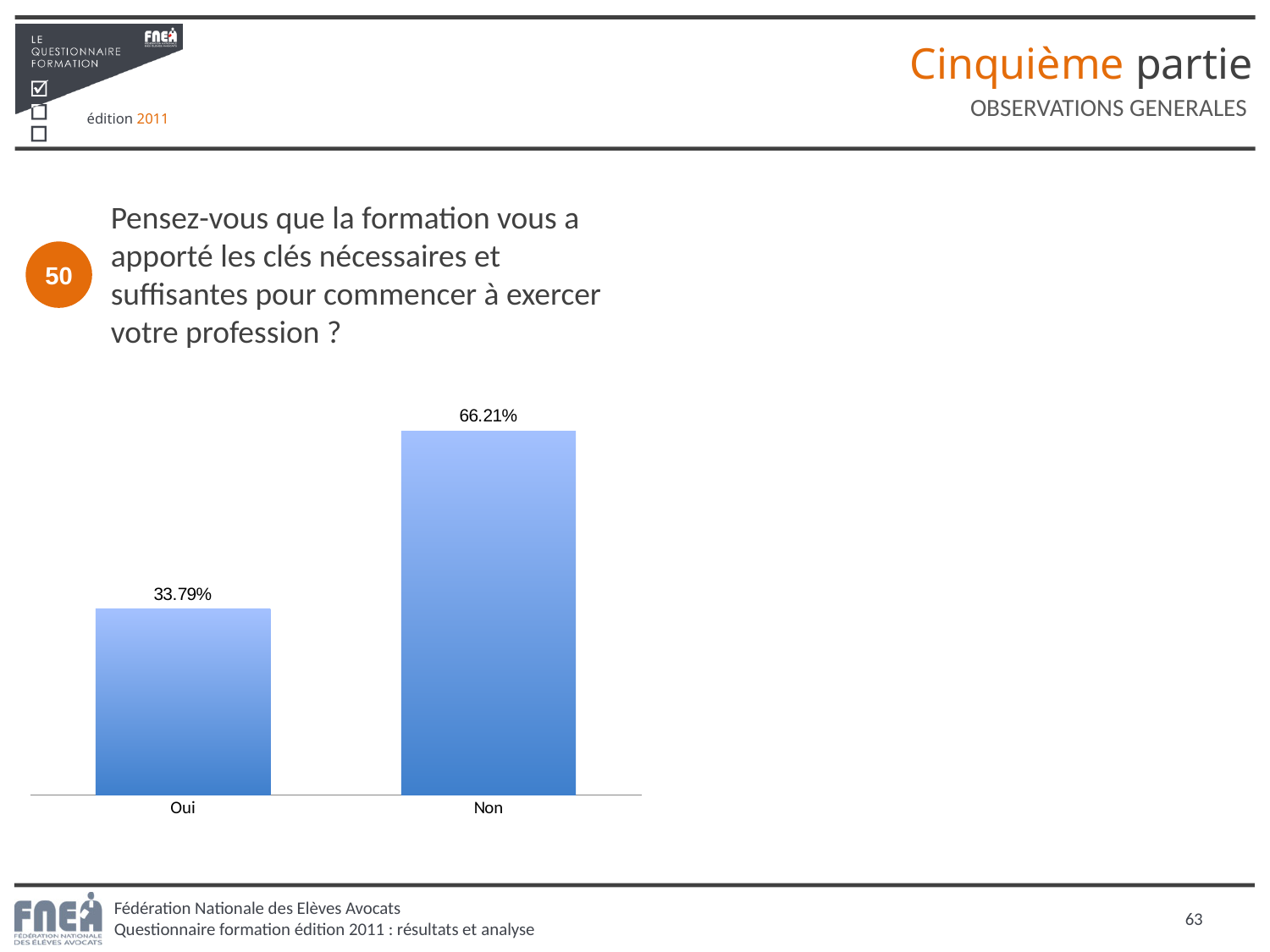
How many categories are shown in the chart? 2 What question number is shown next to the survey question on the slide? 50 What is the value for Oui? 33.79% What kind of chart is shown on the slide? Bar chart Which category has the lowest value? Oui Which is larger, the value for Oui or the value for Non? Non What is the value for Non? 66.21% What is the difference between the values for Non and Oui? 32.42% What are the two category labels on the x axis of the chart? Oui and Non Which category has the highest value? Non What is the total of the two values shown in the chart? 100%